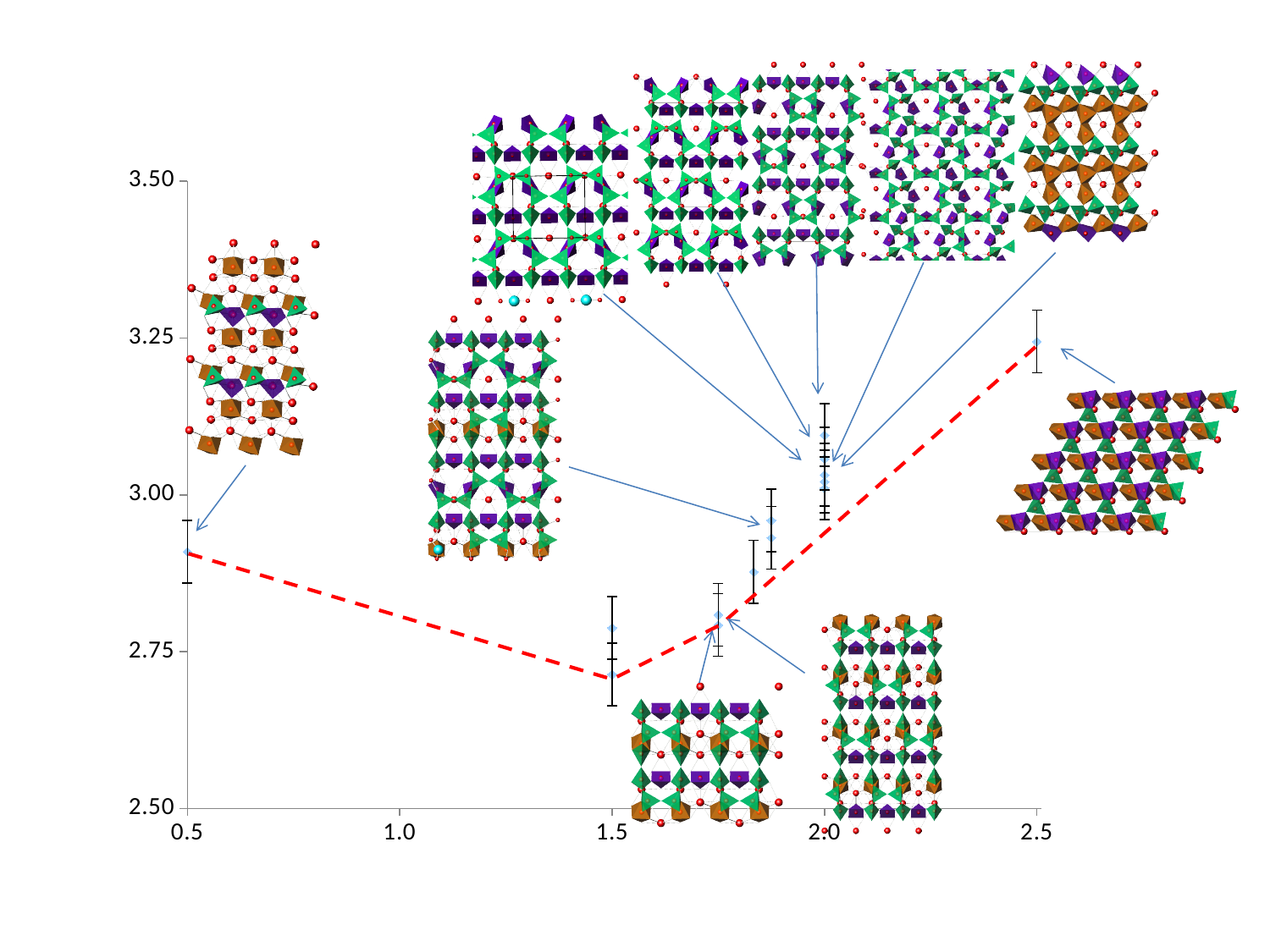
Which has the larger plotted value, x = 0.5 or x = 2.5? 2.5 Are the plotted values at x = 2.0 greater or less than 2.75? greater Is the plotted value at x = 0.5 greater or less than 2.75? greater What colour is the dashed trend line on the chart? red Is the plotted value at x = 2.5 greater or less than 3.00? greater Does the red dashed line rise or fall between x = 0.5 and x = 1.5? falls At which x value is the highest plotted point located? 2.5 Which has the larger plotted value, x = 0.5 or x = 1.5? 0.5 Does the red dashed line rise or fall between x = 1.5 and x = 2.5? rises What kind of chart is shown on the slide? scatter chart